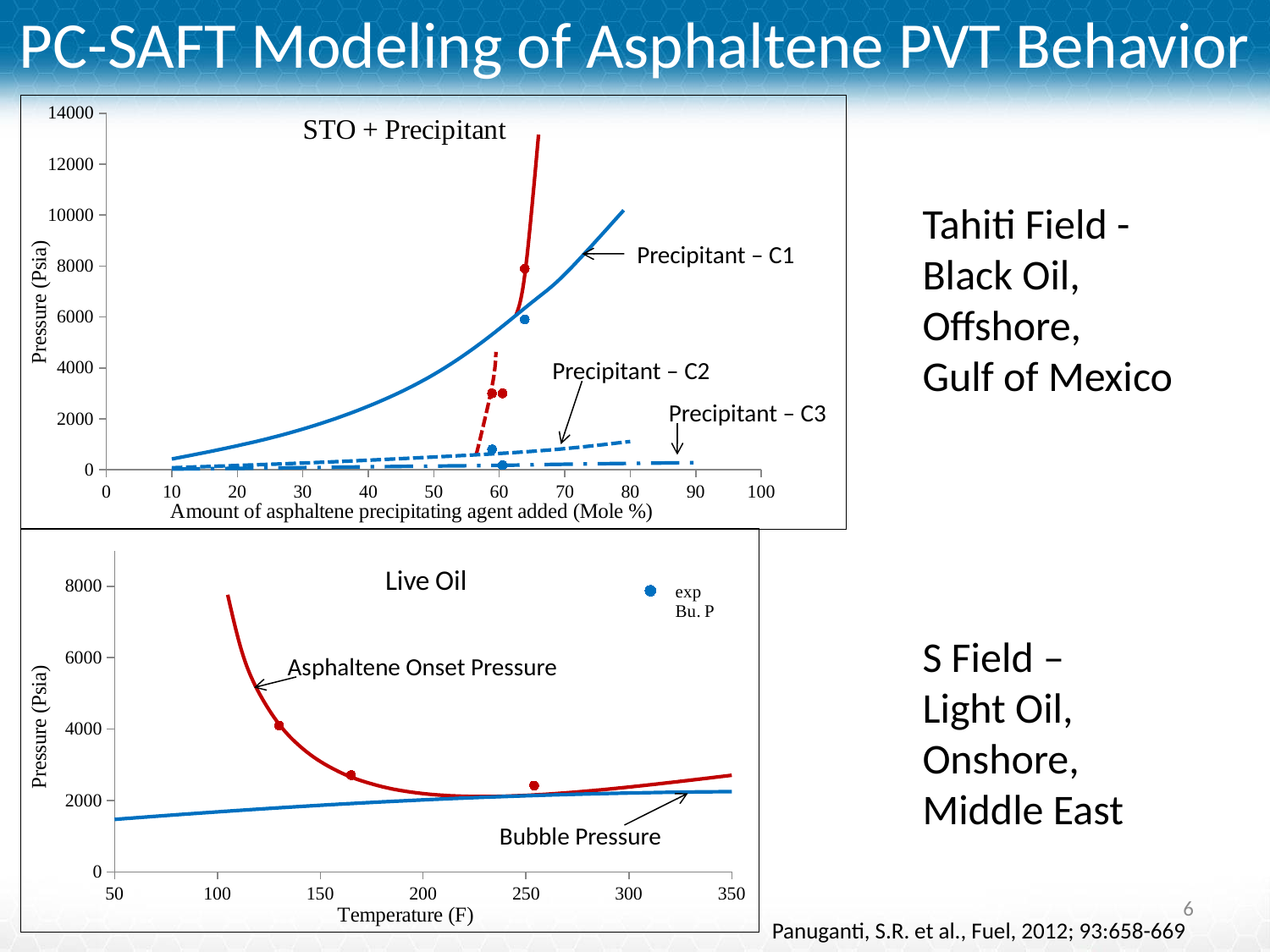
In the 'Live Oil' chart, is the Bubble Pressure at 350 F greater or less than 4000 Psia? less In the 'STO + Precipitant' chart, is the Precipitant – C1 curve at 80 mole % greater or less than 6000 Psia? greater In the 'Live Oil' chart, which is higher at 130 F, the Asphaltene Onset Pressure or the Bubble Pressure? Asphaltene Onset Pressure In the 'Live Oil' chart, how many entries does the legend list? 1 In the 'Live Oil' chart, what is the title of the x axis? Temperature (F) In the 'STO + Precipitant' chart, which curve is higher at 80 mole %, Precipitant – C1 or Precipitant – C3? Precipitant – C1 In the 'STO + Precipitant' chart, is the Precipitant – C3 curve at 80 mole % greater or less than 2000 Psia? less In the 'STO + Precipitant' chart, does the Precipitant – C1 curve rise or fall as the amount of precipitating agent increases? rise What kind of chart is the 'STO + Precipitant' chart at the top of the slide? line chart In the 'STO + Precipitant' chart, how many precipitant curves are labelled? 3 In the 'STO + Precipitant' chart, what is the title of the x axis? Amount of asphaltene precipitating agent added (Mole %)